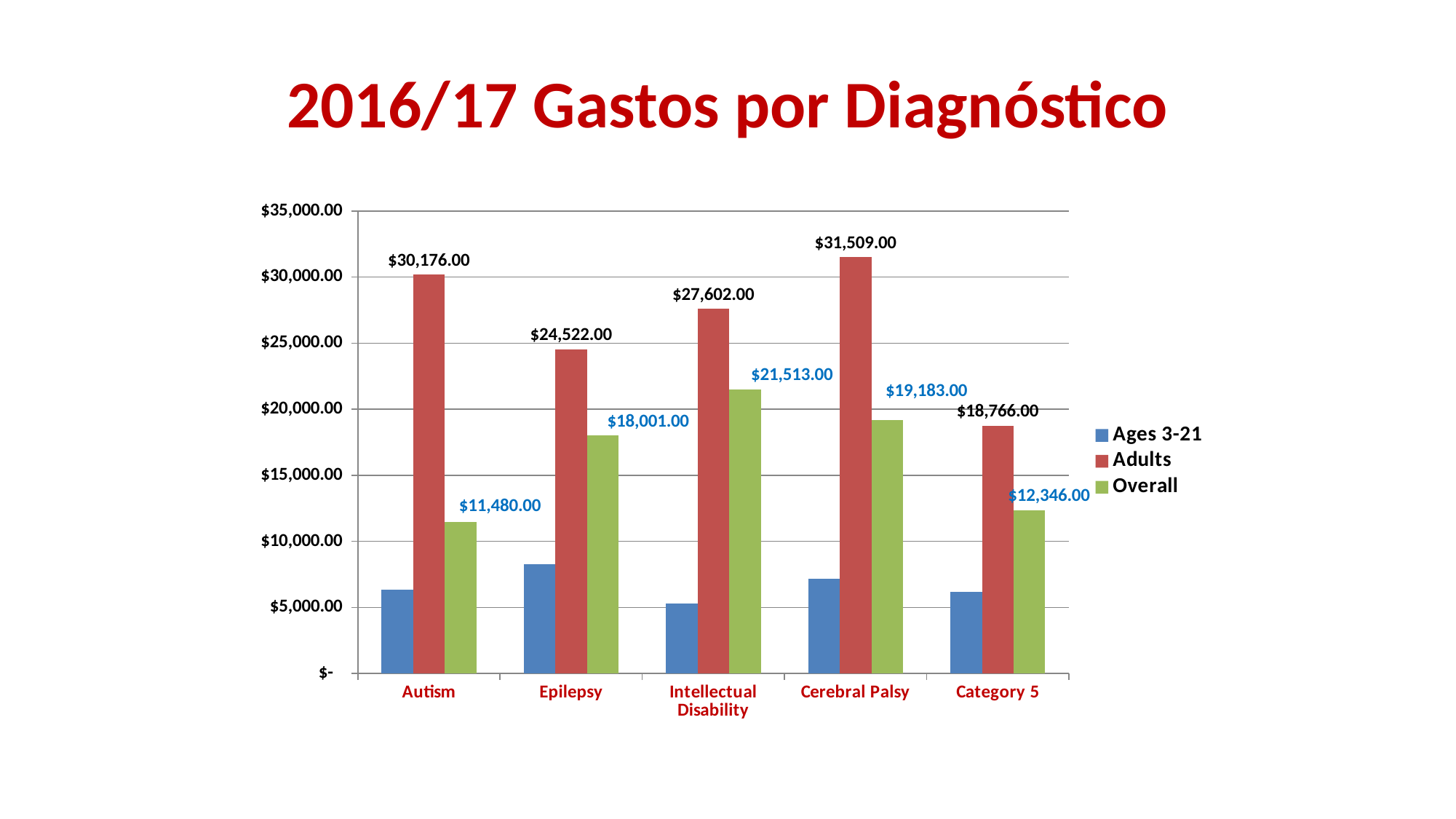
What kind of chart is shown on the slide? bar chart What is the Adults value for Category 5? $18,766.00 Which diagnosis has the lowest Overall value? Autism How many series does the legend list? 3 Which diagnosis has the highest Adults value? Cerebral Palsy What is the Overall value for Intellectual Disability? $21,513.00 Is the Ages 3-21 value for Epilepsy greater or less than $10,000.00? less What is the Adults value for Autism? $30,176.00 Which has the larger Overall value, Epilepsy or Cerebral Palsy? Cerebral Palsy What is the difference between the Adults values for Cerebral Palsy and Autism? $1,333.00 What is the difference between the Overall values for Intellectual Disability and Category 5? $9,167.00 How many diagnosis categories are shown on the x axis? 5